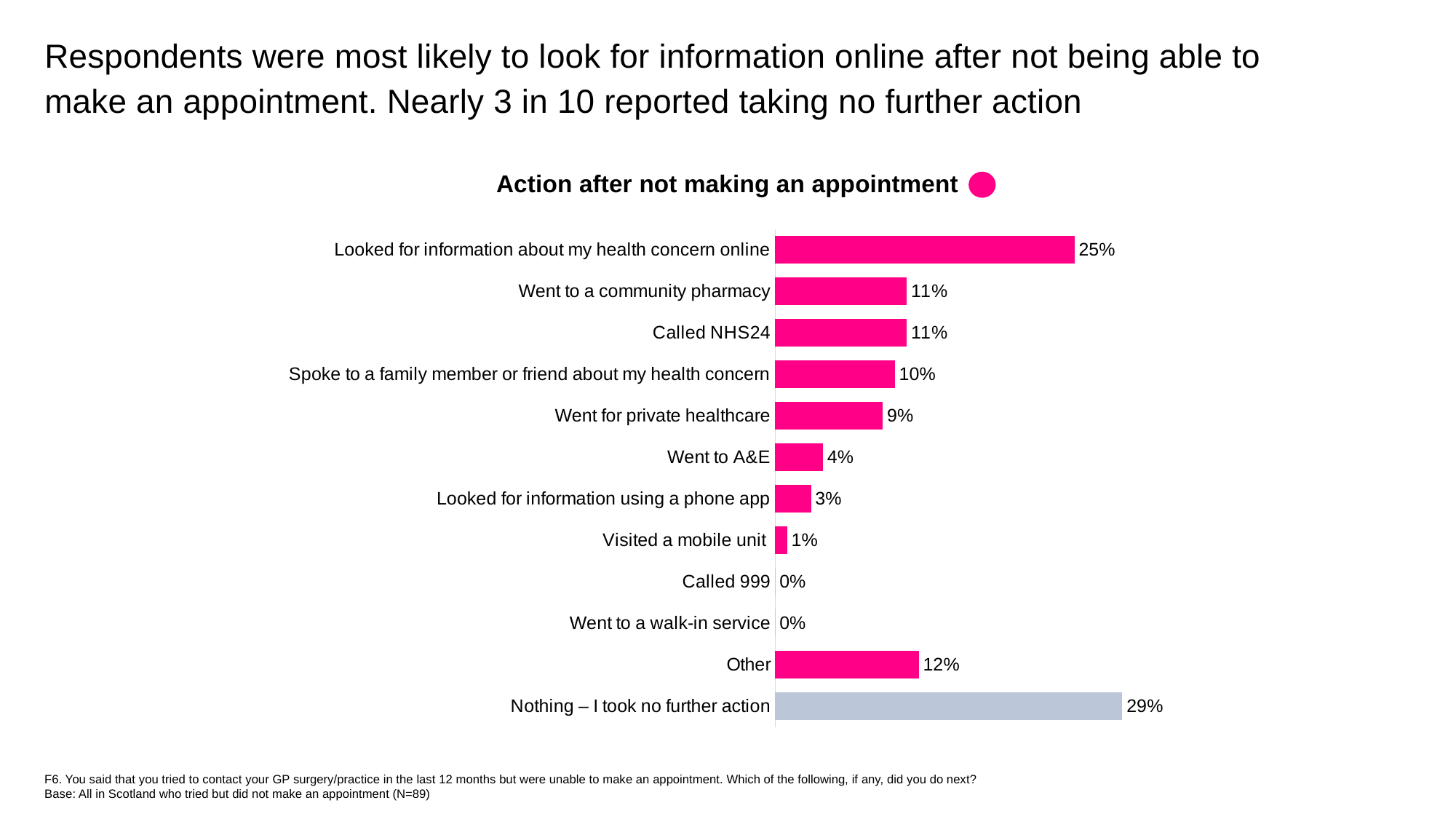
Which is larger: 'Other' or 'Spoke to a family member or friend about my health concern'? Other What is the difference between 'Looked for information about my health concern online' and 'Went to A&E'? 21% What is the title of the chart? Action after not making an appointment What is the value for 'Went to a community pharmacy'? 11% How many categories are shown in the chart? 12 What percentage of respondents went for private healthcare? 9% What type of chart is shown on the slide? Bar chart Which category has the highest value in the chart? Nothing – I took no further action What percentage of respondents looked for information about their health concern online? 25% What is the value for 'Nothing – I took no further action'? 29% Which categories have a value of 0%? Called 999 and Went to a walk-in service Which bar is shown in a different colour (grey) from the others? Nothing – I took no further action